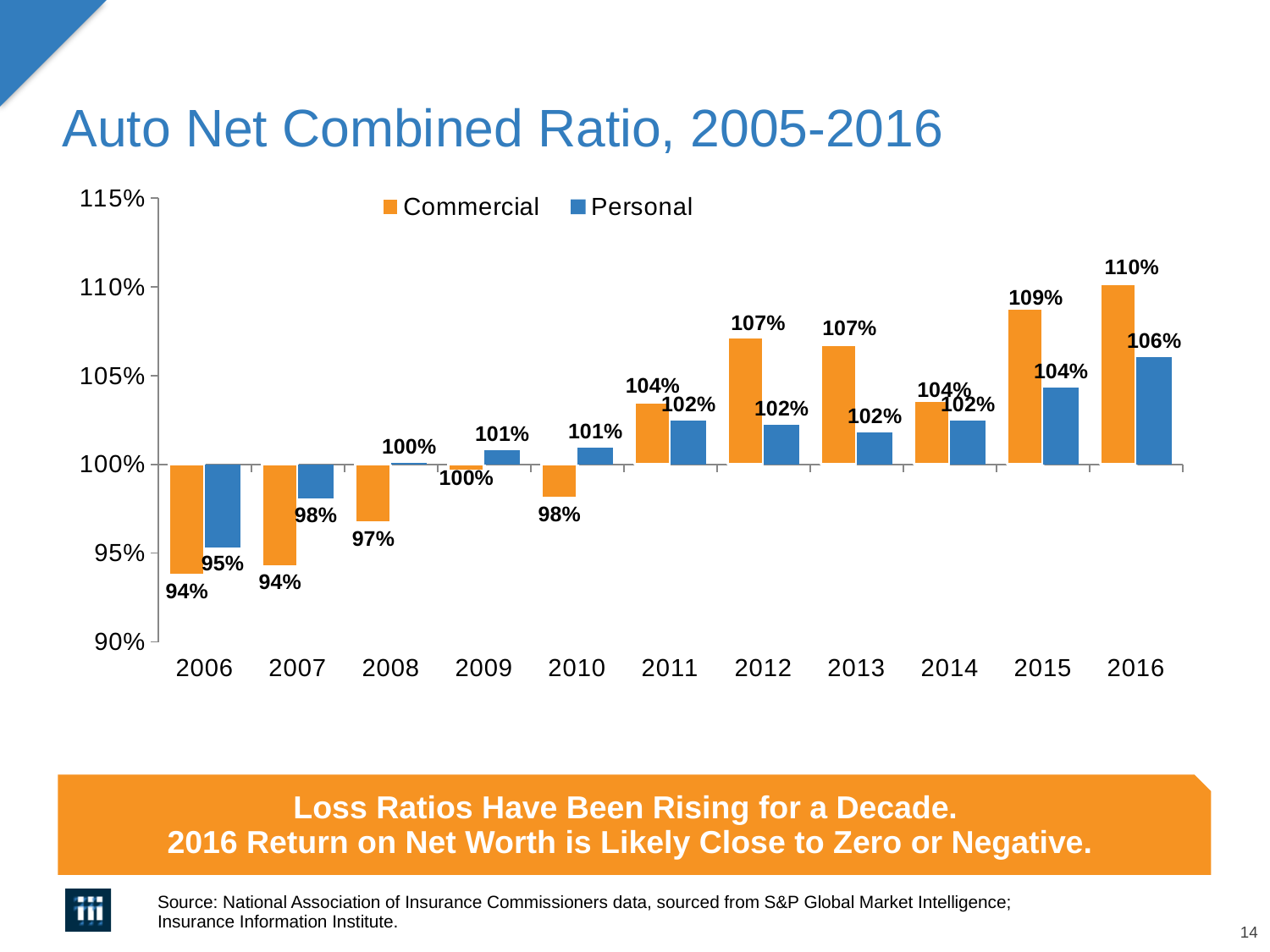
What is the Commercial combined ratio in 2016? 110% What is the difference between the Commercial and Personal combined ratios in 2012? 5% In which year is the Personal combined ratio lowest? 2006 In which year is the Commercial combined ratio highest? 2016 Which is larger in 2008, the Commercial or the Personal combined ratio? Personal Does the Commercial combined ratio generally rise or fall from 2010 to 2016? Rise What kind of chart is shown on the slide? Bar chart What is the Personal combined ratio in 2015? 104% What is the Personal combined ratio in 2007? 98% How many years are shown on the x axis? 11 What is the Commercial combined ratio in 2010? 98% How many series does the legend list? 2